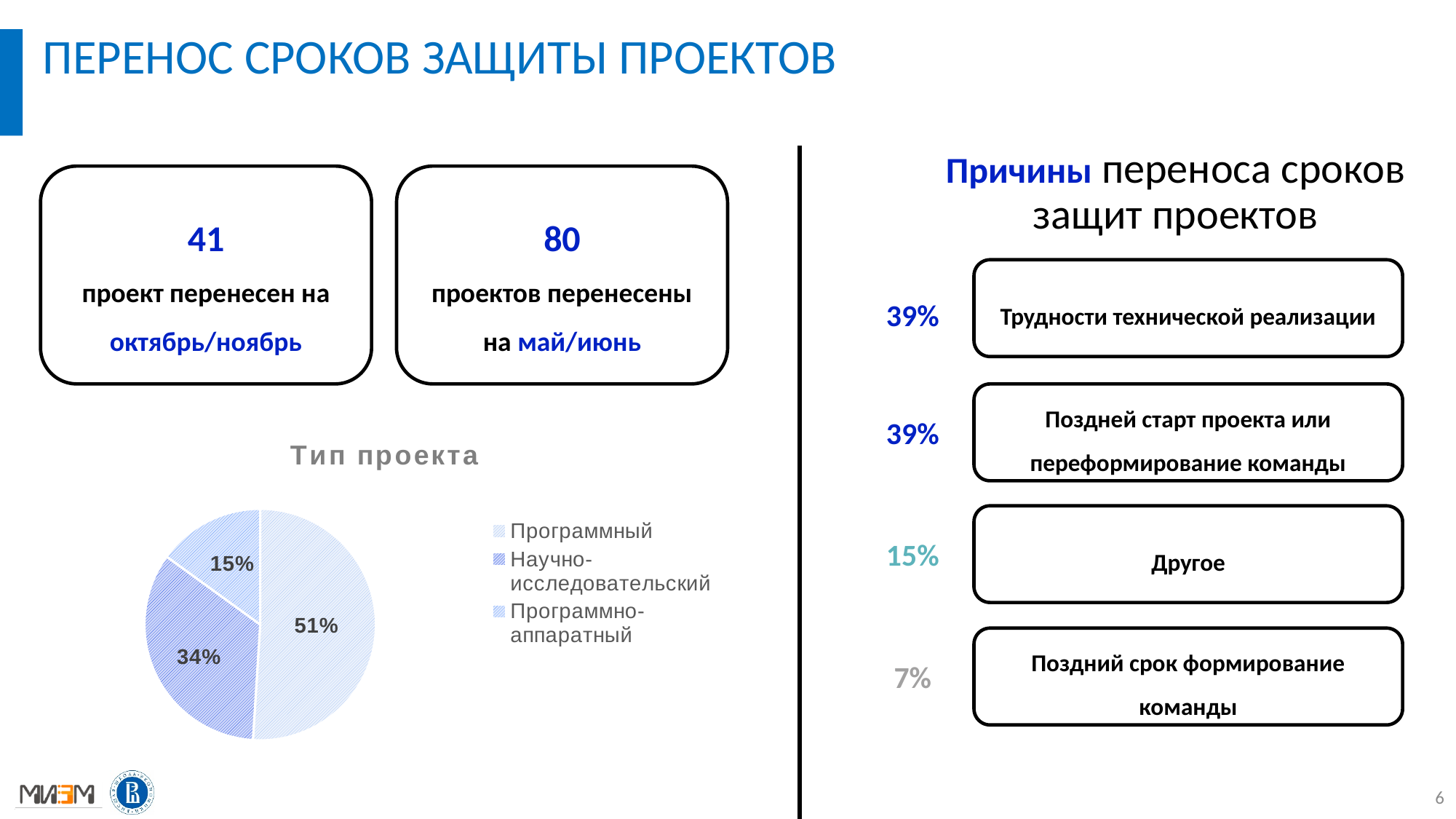
In the "Тип проекта" pie chart, what share does "Программно-аппаратный" have? 15% How many slices does the "Тип проекта" pie chart have? 3 What is the title of the pie chart on the slide? Тип проекта Which project type has the smallest slice in the "Тип проекта" pie chart? Программно-аппаратный What kind of chart is shown under the title "Тип проекта"? pie chart In the "Тип проекта" pie chart, what is the difference in percentage points between "Научно-исследовательский" and "Программно-аппаратный"? 19 Which project type has the largest slice in the "Тип проекта" pie chart? Программный In the "Тип проекта" pie chart, which is larger: "Научно-исследовательский" or "Программно-аппаратный"? Научно-исследовательский In the "Тип проекта" pie chart, what share does "Научно-исследовательский" have? 34% In the "Тип проекта" pie chart, what share does "Программный" have? 51% In the "Тип проекта" pie chart, what is the difference in percentage points between "Программный" and "Научно-исследовательский"? 17 How many entries does the legend of the "Тип проекта" pie chart list? 3